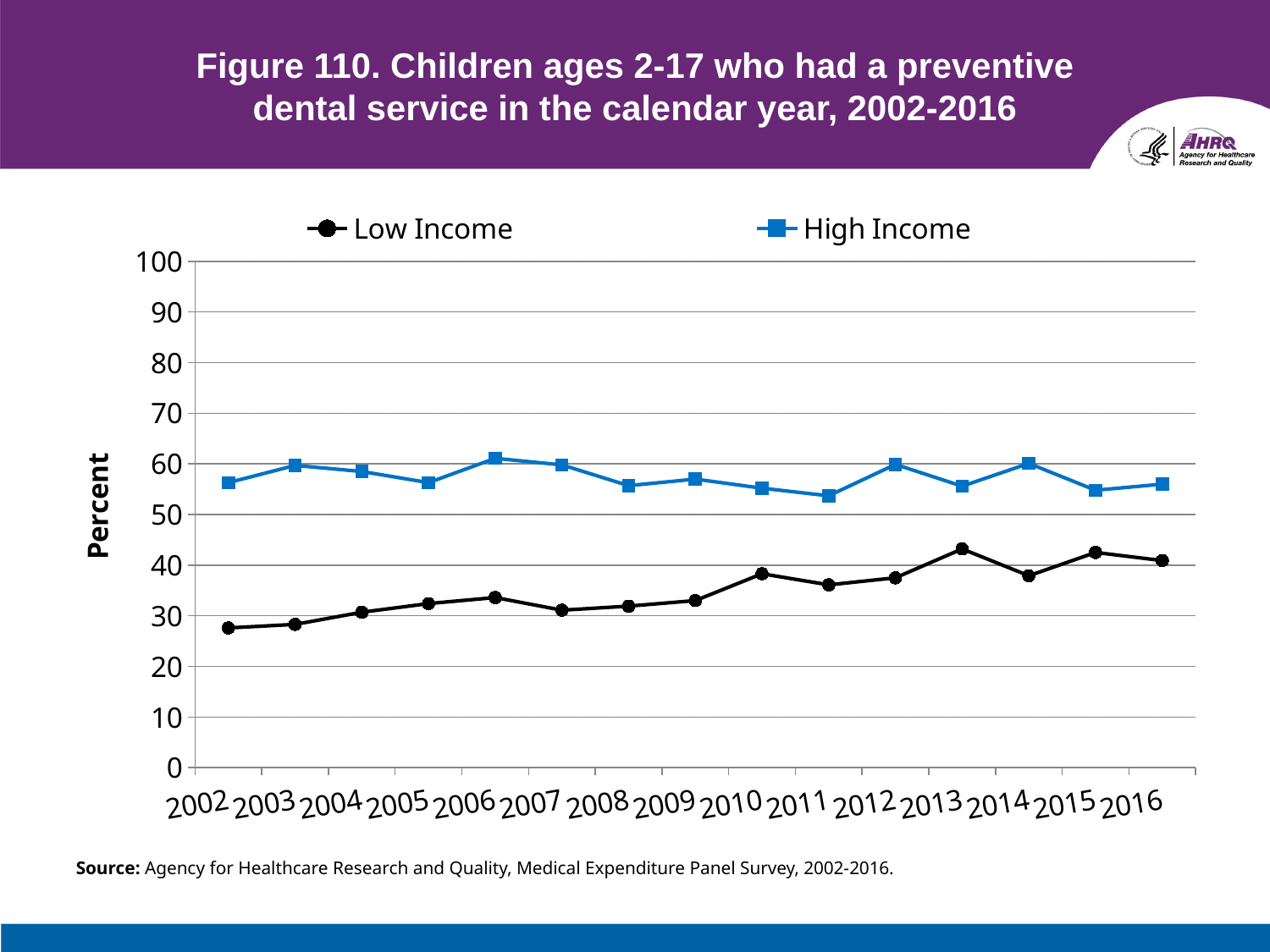
In 2016, which series has the larger value, Low Income or High Income? High Income Is the value for Low Income in 2007 greater or less than 40? less Which series is shown with blue square markers? High Income Is the value for Low Income in 2013 greater or less than 40? greater Is the value for High Income in 2011 greater or less than 60? less How many series does the legend list? 2 How many years are plotted along the x axis? 15 What is the label on the vertical axis? Percent Does the Low Income series generally rise or fall from 2002 to 2016? rise What kind of chart is shown on the slide? line chart